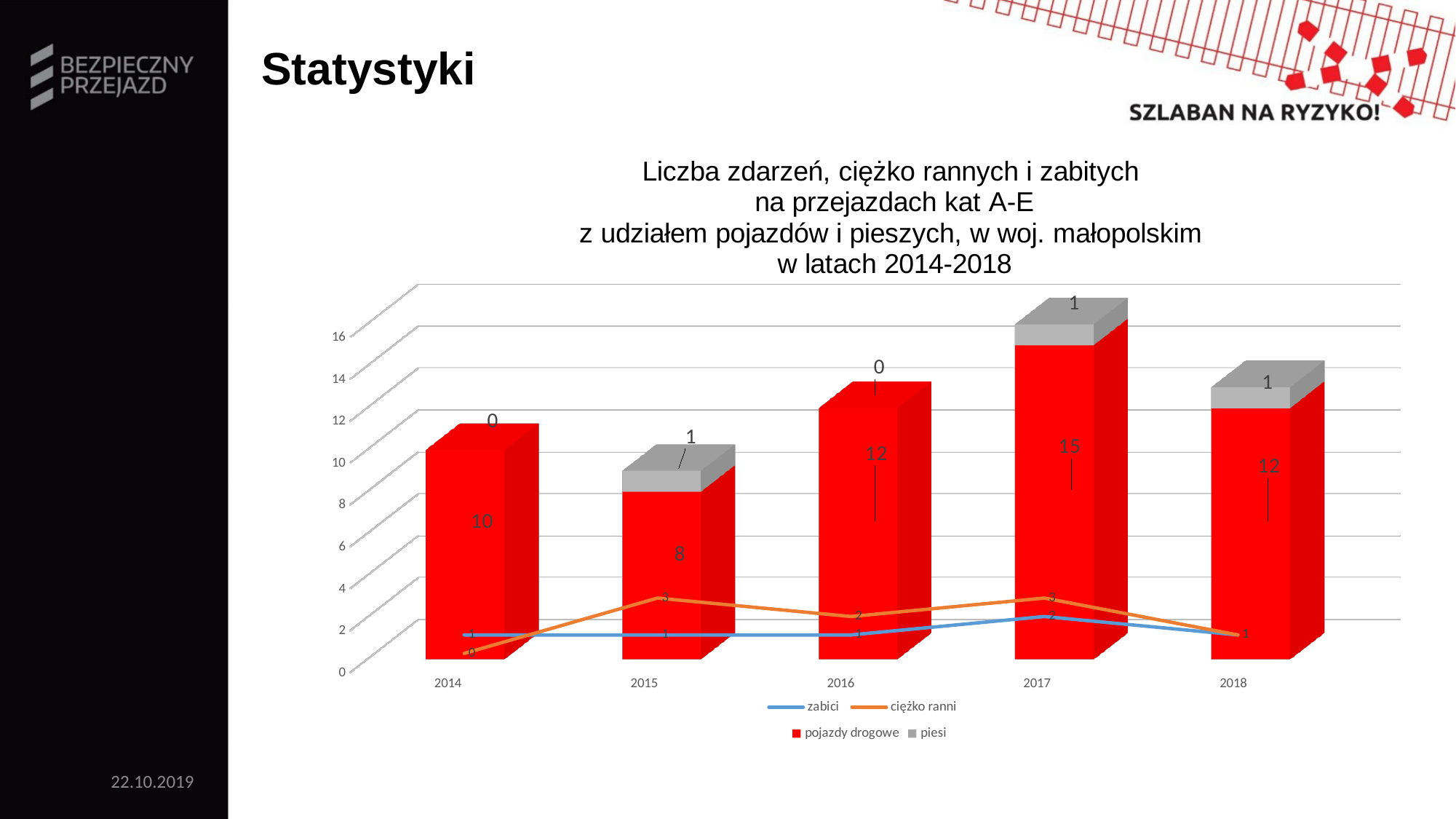
How many series does the legend list? 4 What is the difference between the pojazdy drogowe values for 2017 and 2015? 7 Which year has the larger pojazdy drogowe value, 2014 or 2016? 2016 What is the value for pojazdy drogowe in 2017? 15 How many years are shown on the x axis? 5 In which year is the value for pojazdy drogowe the lowest? 2015 What is the value for ciężko ranni in 2015? 3 What is the value for pojazdy drogowe in 2015? 8 What is the value for piesi in 2018? 1 In which year is the value for pojazdy drogowe the highest? 2017 What kind of chart is this? Combination of stacked bar chart and line chart What is the total of the stacked bar for 2017 (pojazdy drogowe plus piesi)? 16